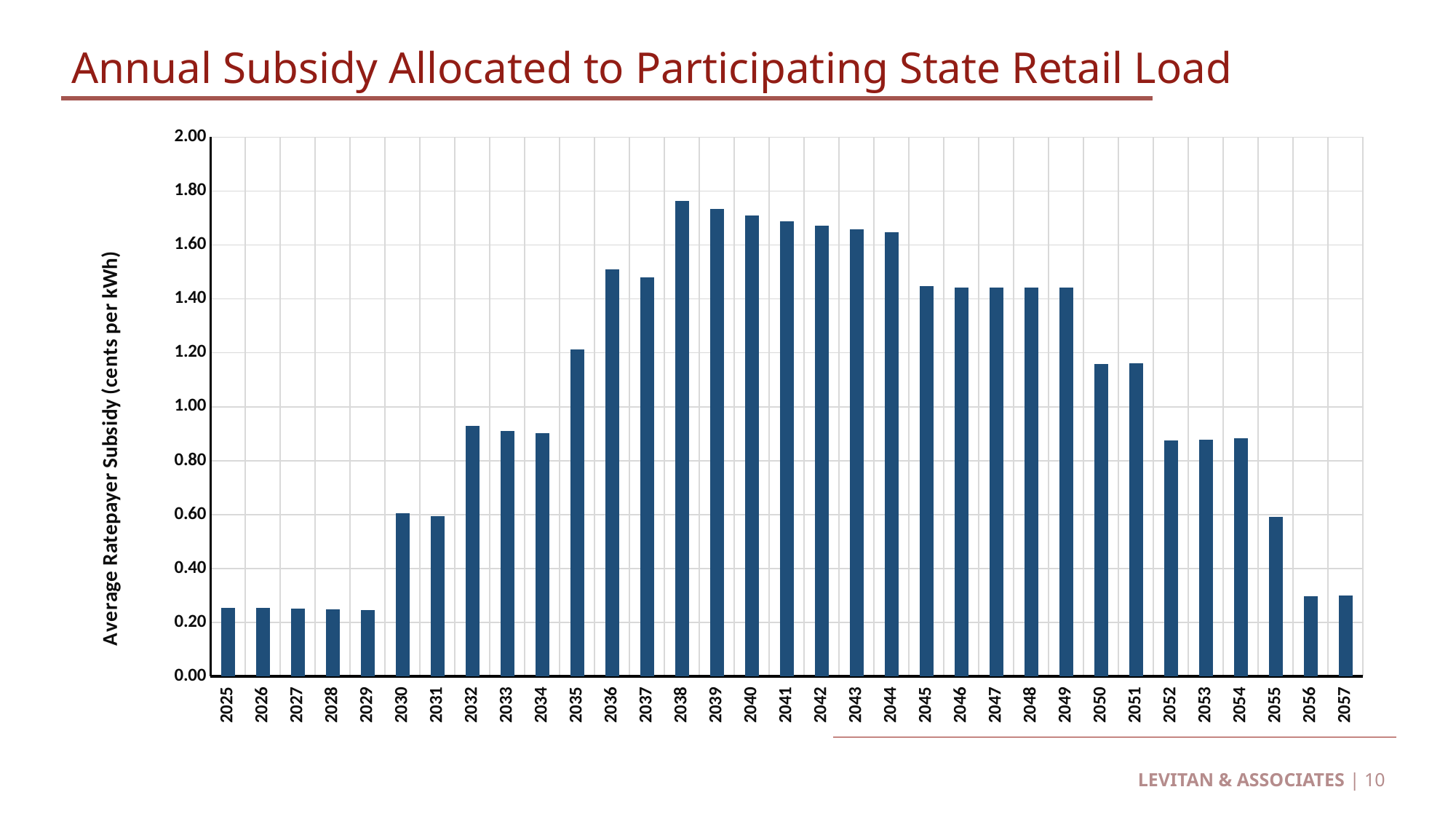
What is the label on the vertical axis? Average Ratepayer Subsidy (cents per kWh) Do the values rise or fall from 2038 to 2044? fall Which is larger, the value for 2038 or the value for 2044? 2038 Is the value for 2056 greater or less than 0.40? less How many years are plotted along the x axis? 33 Which year has the highest average ratepayer subsidy? 2038 Is the value for 2032 greater or less than 1.00? less Is the value for 2050 greater or less than 1.20? less Which is larger, the value for 2036 or the value for 2037? 2036 What kind of chart is shown on the slide? Bar chart